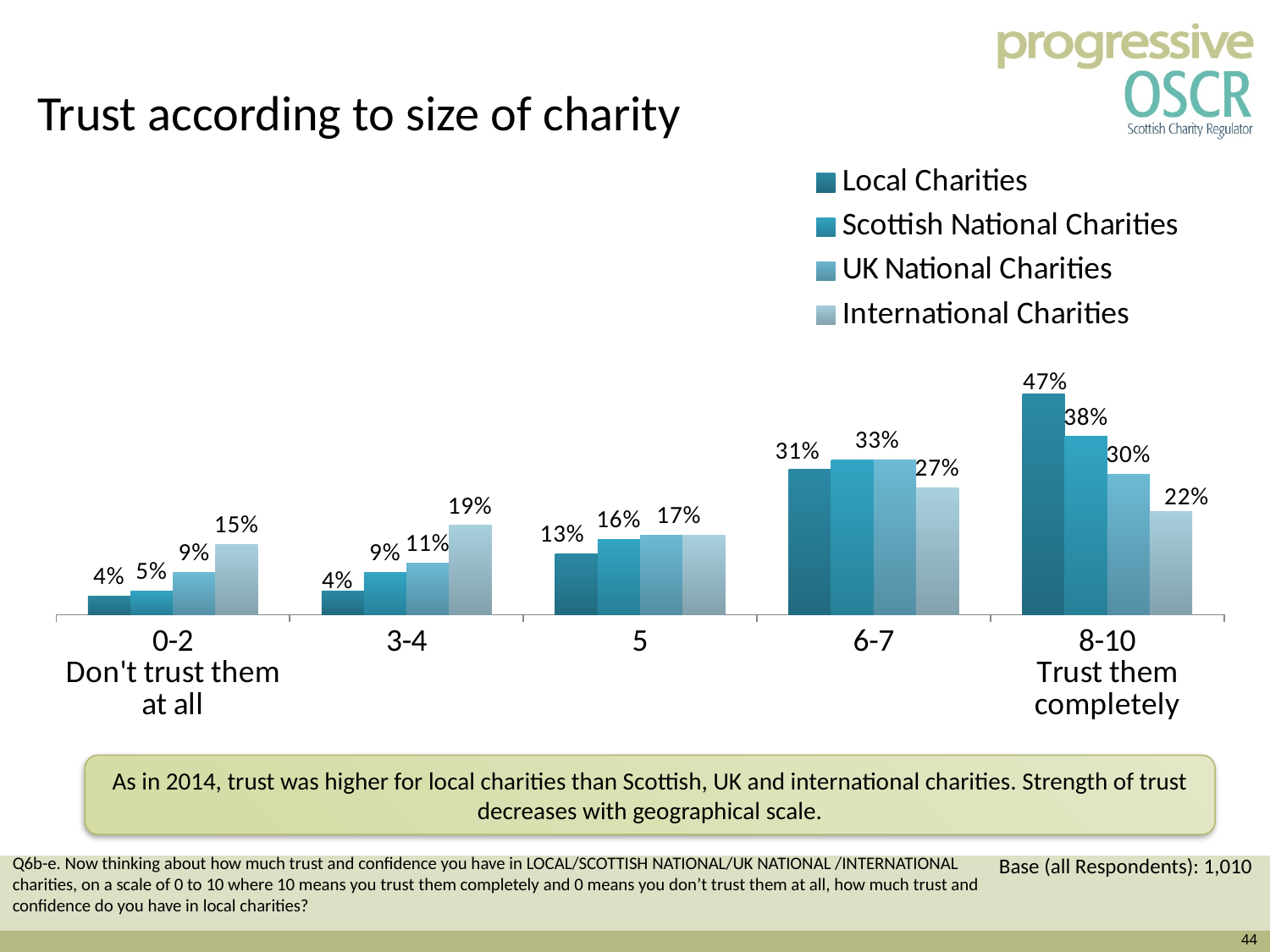
What is the value for International Charities in the 0-2 (Don't trust them at all) category? 15% How many rating categories are shown on the x axis? 5 Does the value for Local Charities rise or fall from the 0-2 category to the 8-10 category? Rises What is the value for Scottish National Charities in the 8-10 category? 38% What percentage of respondents rated their trust in Local Charities as 8-10 (Trust them completely)? 47% What is the value for Local Charities in the 5 category? 13% Which series has the highest value in the 8-10 (Trust them completely) category? Local Charities What is the value for UK National Charities in the 3-4 category? 11% What is the difference between Local Charities and International Charities in the 8-10 category? 25 percentage points Which series has the lowest value in the 8-10 (Trust them completely) category? International Charities In the 3-4 category, which is larger: the value for Local Charities or for International Charities? International Charities How many series does the legend list? 4